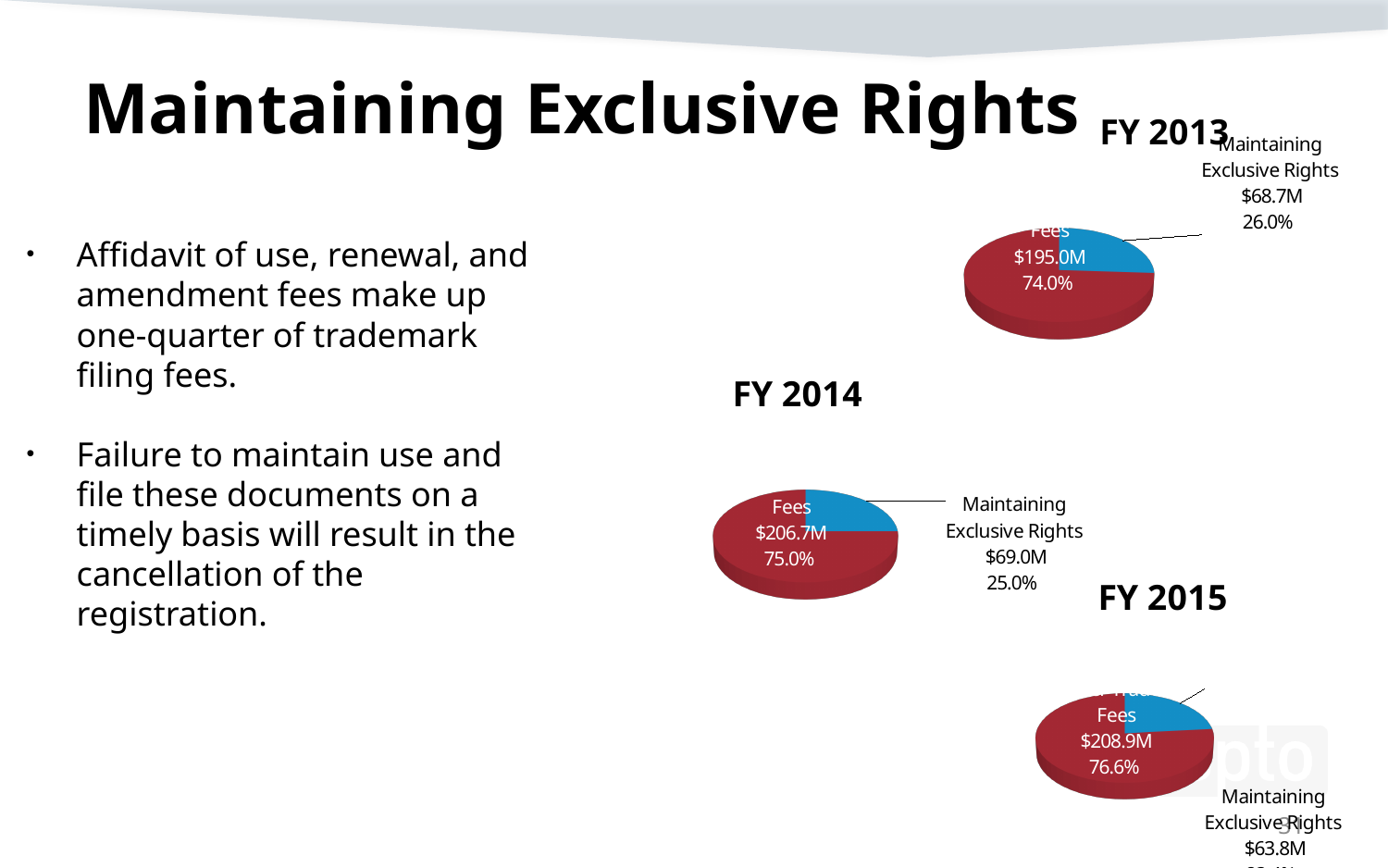
In the FY 2013 chart, what is the value for Fees? $195.0M In the FY 2013 chart, what share of the pie is Maintaining Exclusive Rights? 26.0% In the FY 2015 chart, what is the value for Fees? $208.9M In the FY 2013 chart, what is the difference between the Fees value and the Maintaining Exclusive Rights value? $126.3M How many pie charts are shown on the slide? 3 In the FY 2014 chart, which slice is larger, Fees or Maintaining Exclusive Rights? Fees What kind of chart is used for FY 2014? pie chart In the FY 2014 chart, what is the value for Maintaining Exclusive Rights? $69.0M How many slices does the FY 2013 pie chart have? 2 In the FY 2015 chart, what share of the pie is Fees? 76.6% In the FY 2015 chart, what is the value for Maintaining Exclusive Rights? $63.8M In the FY 2014 chart, what share of the pie is Fees? 75.0%